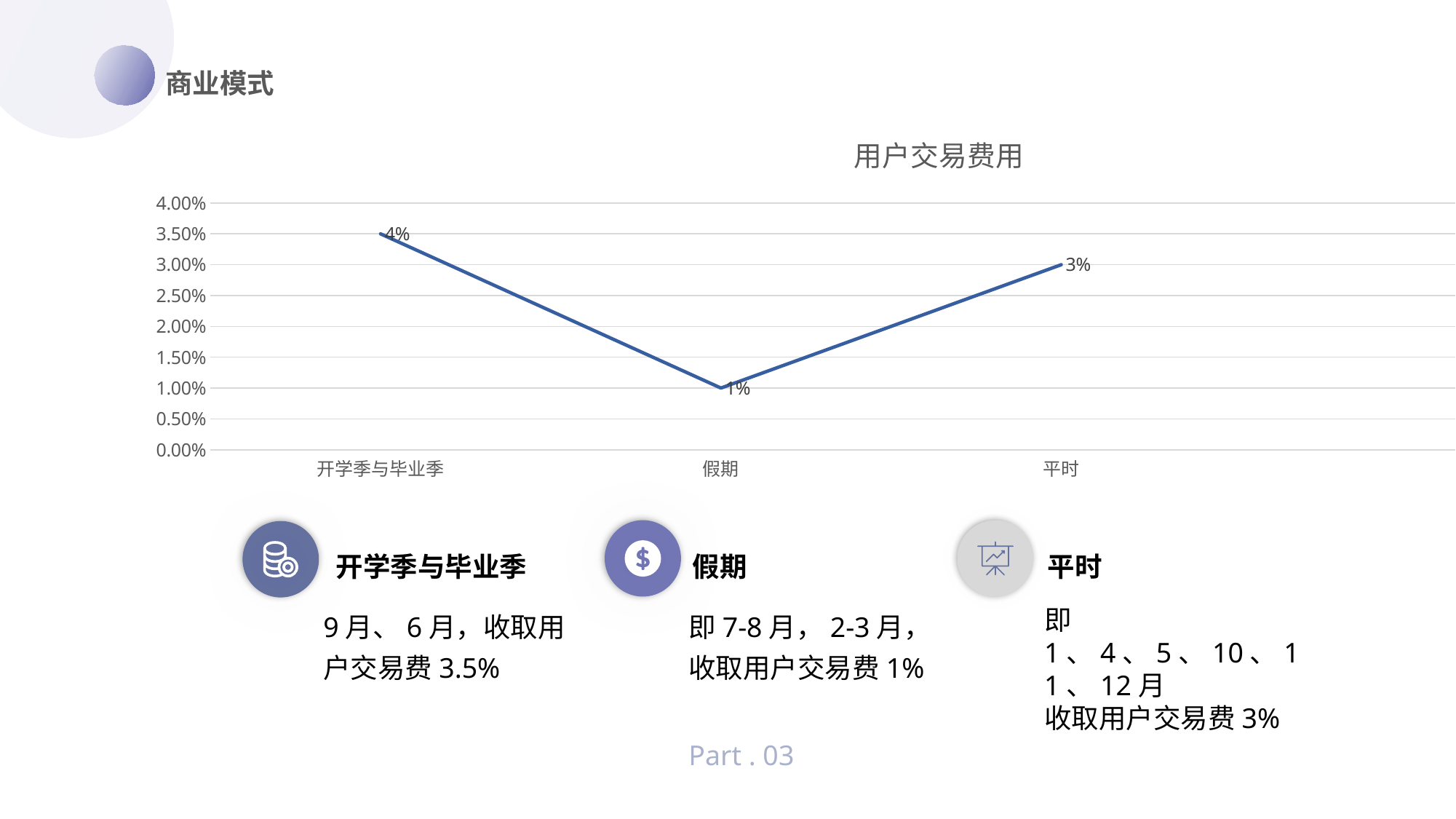
Which is larger, the value for 平时 or the value for 假期? 平时 Is the value for 开学季与毕业季 greater or less than 3.00%? greater What is the value shown for 平时? 3% Is the value for 假期 greater or less than 2.00%? less What kind of chart is shown on the slide? line chart What is the value shown for 假期? 1% Which category has the lowest value? 假期 Which category has the highest value? 开学季与毕业季 How does the line move from 开学季与毕业季 to 假期 to 平时? falls, then rises How many categories are plotted on the x axis of the chart? 3 What is the title of the chart? 用户交易费用 What is the difference between the value for 平时 and the value for 假期? 2%